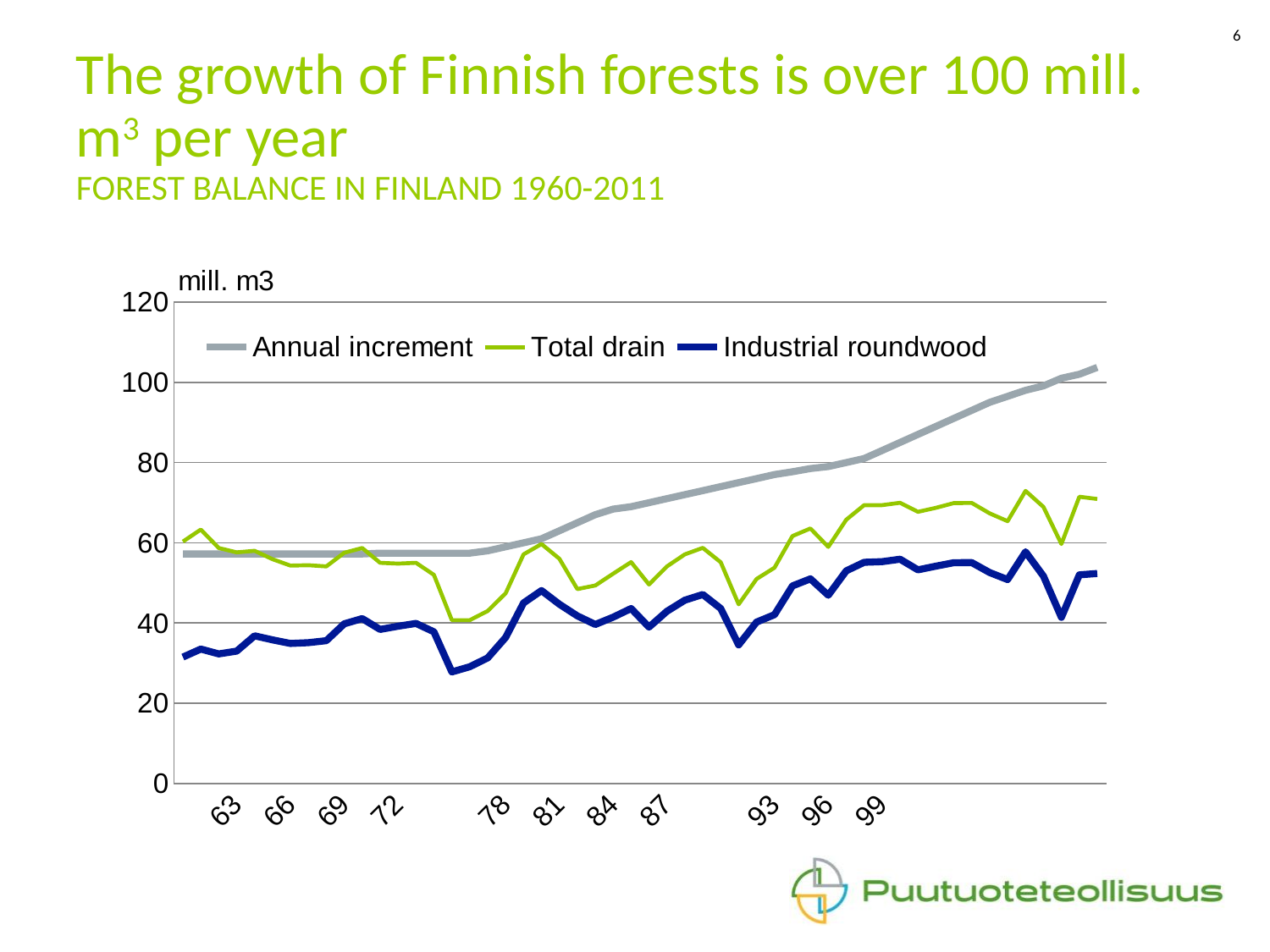
At 93, which is larger: Annual increment or Total drain? Annual increment How many series does the chart legend list? 3 Which series is shown in grey in the chart? Annual increment Does the Annual increment series rise or fall overall from left to right along the x axis? Rise Which series has the highest value at the right-hand end of the chart? Annual increment Is the value for Annual increment at 87 greater or less than 60? greater What unit is shown at the top of the vertical axis of the chart? mill. m3 Is the value for Industrial roundwood at 63 greater or less than 40? less Is the value for Industrial roundwood at 99 greater or less than 60? less At 87, which is larger: Total drain or Industrial roundwood? Total drain What kind of chart is shown on the slide? Line chart Which series has the lowest value at the right-hand end of the chart? Industrial roundwood